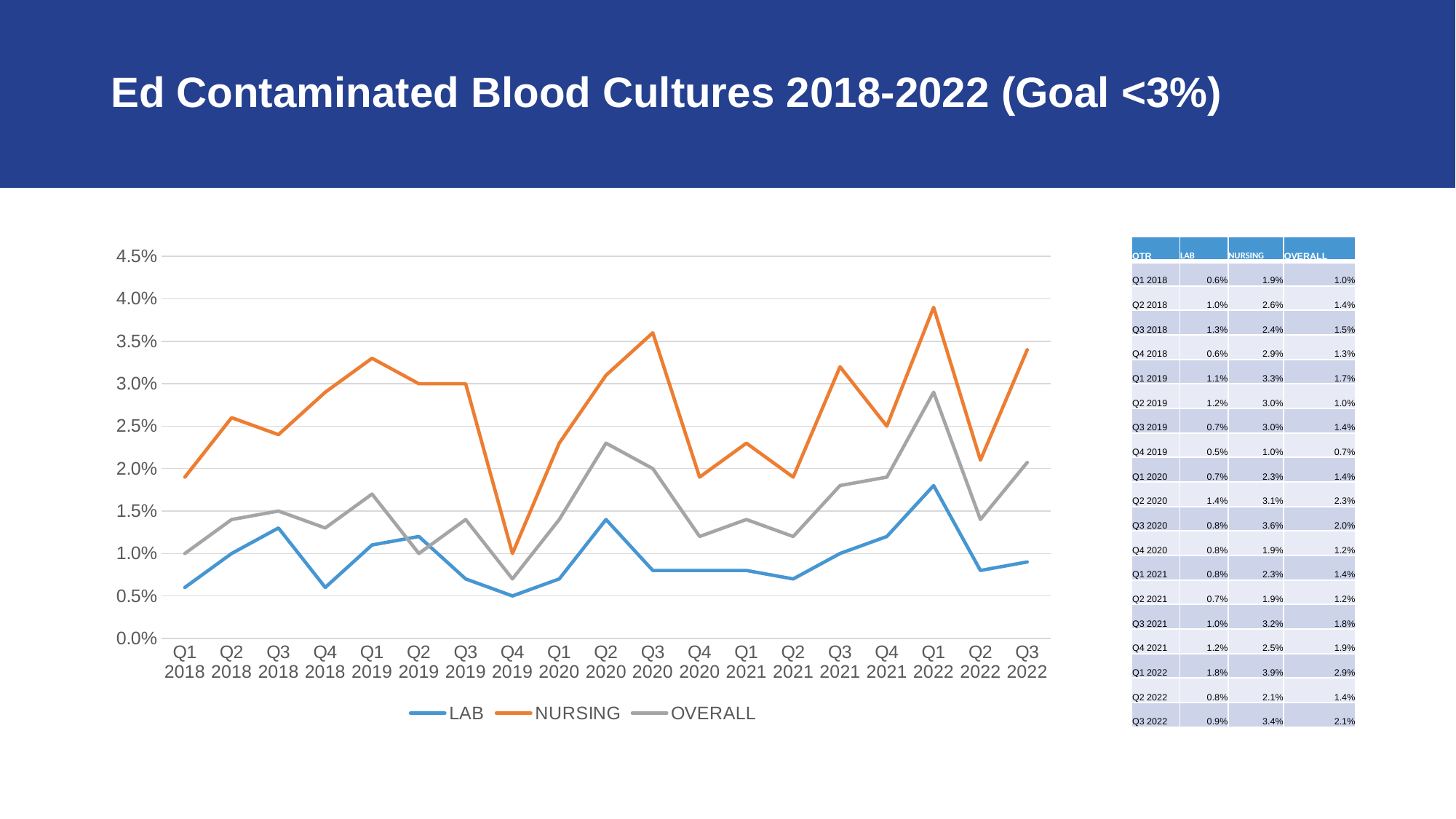
What is the OVERALL value for Q4 2019? 0.7% Does the LAB series rise or fall from Q1 2022 to Q2 2022? fall Is the NURSING value for Q1 2022 greater or less than 3.5%? greater Which is larger, the NURSING value for Q3 2020 or the NURSING value for Q4 2020? Q3 2020 In which quarter does the NURSING series reach its highest value? Q1 2022 What is the LAB value for Q1 2022? 1.8% In which quarter does the LAB series reach its lowest value? Q4 2019 How many quarters are plotted along the x axis of the chart? 19 How many series does the chart legend list? 3 What is the difference between the NURSING and LAB values in Q1 2022? 2.1% What is the NURSING value for Q3 2020? 3.6% What type of chart is shown on the slide? line chart